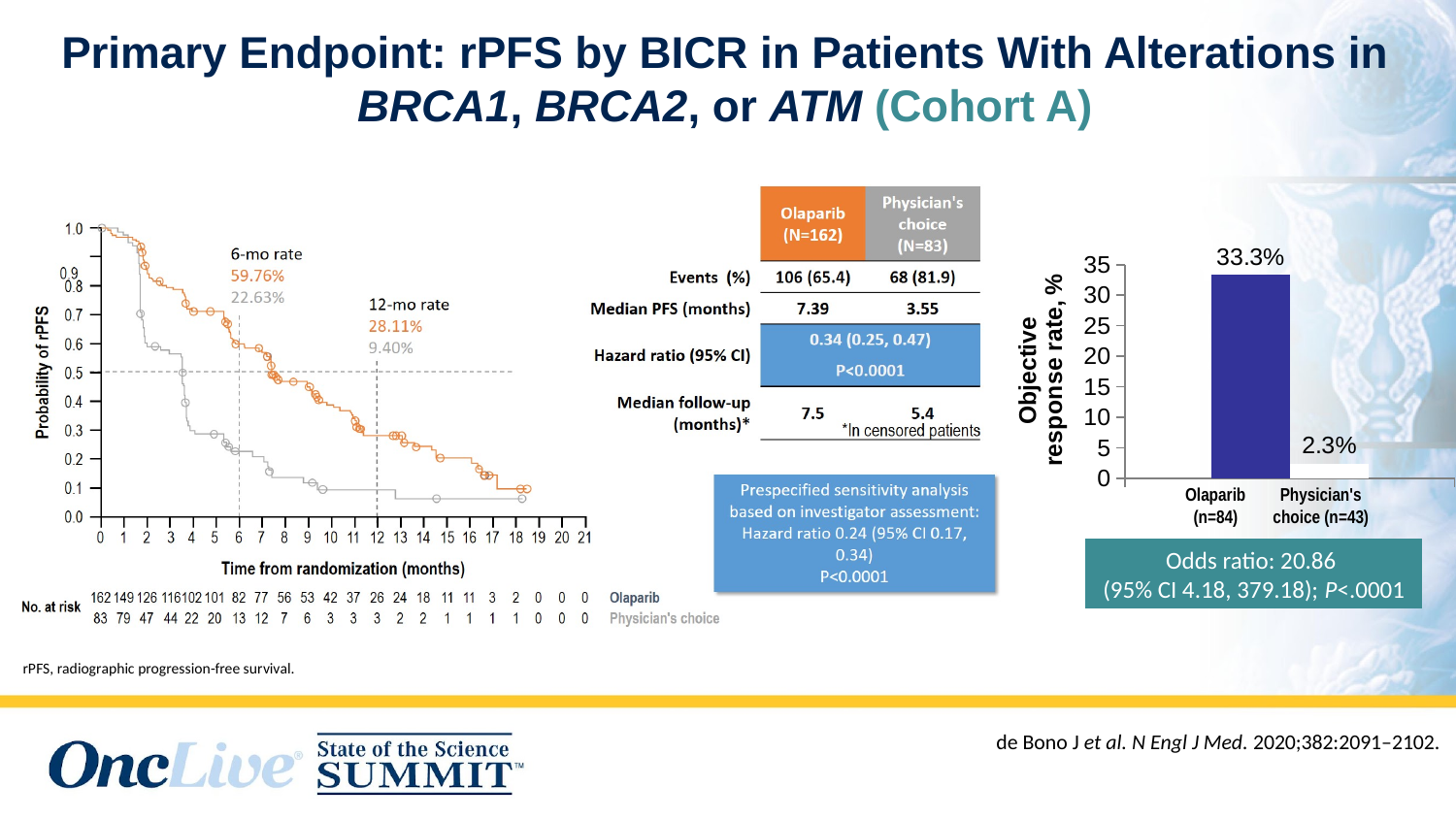
On the Kaplan-Meier rPFS curve on the left, what is the label of the x axis? Time from randomization (months) On the objective response rate bar chart, is the value for Olaparib greater or less than 30? greater On the objective response rate bar chart, what is the difference in objective response rate between Olaparib and Physician's choice? 31.0 percentage points On the Kaplan-Meier rPFS curve on the left, which group has the higher 12-month rPFS rate? Olaparib On the Kaplan-Meier rPFS curve on the left, what is the 12-month rPFS rate for Physician's choice? 9.40% On the objective response rate bar chart, what is the objective response rate for Physician's choice? 2.3% On the Kaplan-Meier rPFS curve on the left, how many patients were at risk in the Olaparib group at time 0? 162 What kind of chart is the objective response rate chart on the right of the slide? Bar chart On the objective response rate bar chart, which group has the higher objective response rate? Olaparib On the objective response rate bar chart, what is the objective response rate for Olaparib? 33.3% On the objective response rate bar chart, how many bars are plotted? 2 On the Kaplan-Meier rPFS curve on the left, what is the 6-month rPFS rate for Olaparib? 59.76%